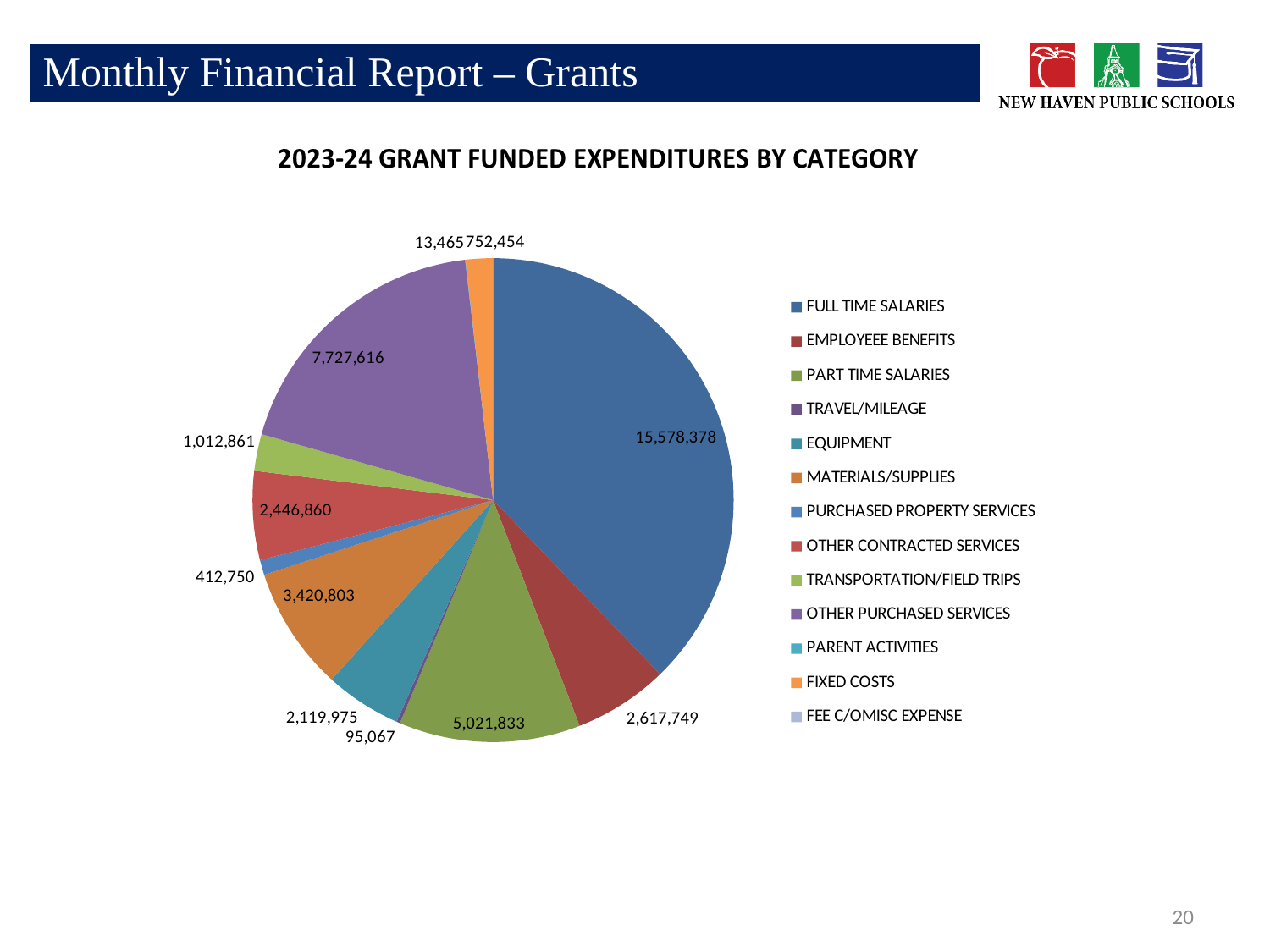
What type of chart is shown on the slide? Pie chart How many categories does the chart's legend list? 13 What is the value for MATERIALS/SUPPLIES? 3,420,803 Which category has the largest slice of the pie? FULL TIME SALARIES What is the value for FIXED COSTS? 752,454 What is the value for PART TIME SALARIES? 5,021,833 What is the difference between PART TIME SALARIES and EMPLOYEEE BENEFITS? 2,404,084 Which is larger, PART TIME SALARIES or MATERIALS/SUPPLIES? PART TIME SALARIES What is the value for OTHER PURCHASED SERVICES? 7,727,616 What is the value for FULL TIME SALARIES? 15,578,378 What is the difference between FULL TIME SALARIES and OTHER PURCHASED SERVICES? 7,850,762 What is the title of the chart? 2023-24 GRANT FUNDED EXPENDITURES BY CATEGORY